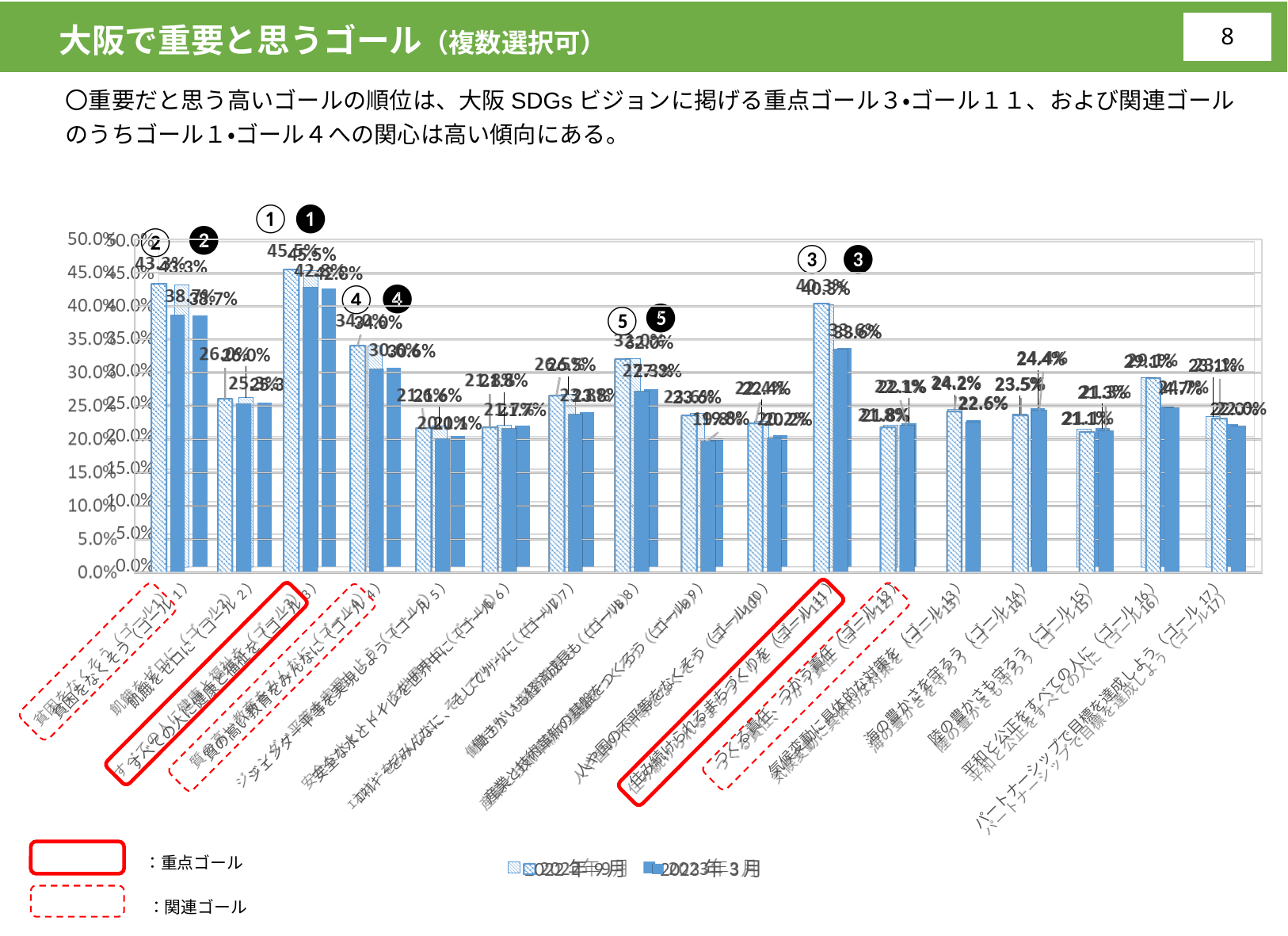
What is the value for 貧困をなくそう（ゴール1） in the 2022年9月 series? 43.3% In the 2022年9月 series, which is larger: 貧困をなくそう（ゴール1） or 住み続けられるまちづくりを（ゴール11）? 貧困をなくそう（ゴール1） What is the difference between the 2022年9月 and 2023年3月 values for 質の高い教育をみんなに（ゴール4）? 3.4 percentage points What is the value for 質の高い教育をみんなに（ゴール4） in the 2023年3月 series? 30.6% How many goal categories are plotted along the x axis? 17 How many series does the legend list? 2 What is the value for 質の高い教育をみんなに（ゴール4） in the 2022年9月 series? 34.0% What kind of chart is shown on the slide? bar chart What is the value for 住み続けられるまちづくりを（ゴール11） in the 2023年3月 series? 33.6% Is the 2022年9月 value for ジェンダー平等を実現しよう（ゴール5） greater or less than 25.0%? less Which two series are listed in the legend? 2022年9月 and 2023年3月 Which goal has the highest value in the 2022年9月 series? すべての人に健康と福祉を（ゴール3）